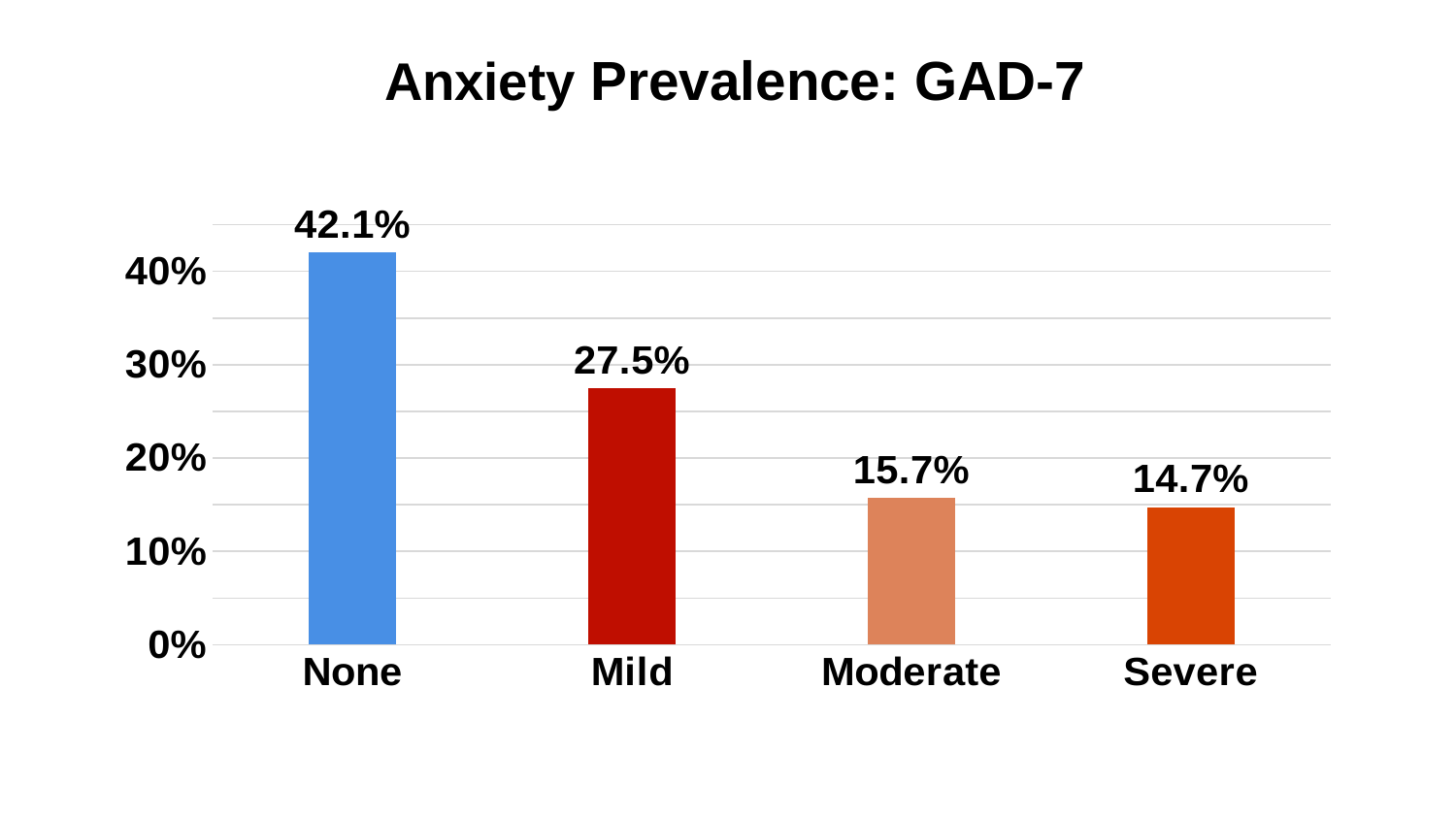
What is the value for Moderate? 15.7% What is the difference between the values for None and Mild? 14.6% What is the value for Mild? 27.5% What is the title of the chart? Anxiety Prevalence: GAD-7 Which is larger, the value for Mild or the value for Moderate? Mild What is the value for None? 42.1% Which category has the lowest value? Severe What kind of chart is this? Bar chart Which category has the highest value? None How many categories are shown on the chart? 4 What is the difference between the values for Moderate and Severe? 1.0% What is the value for Severe? 14.7%